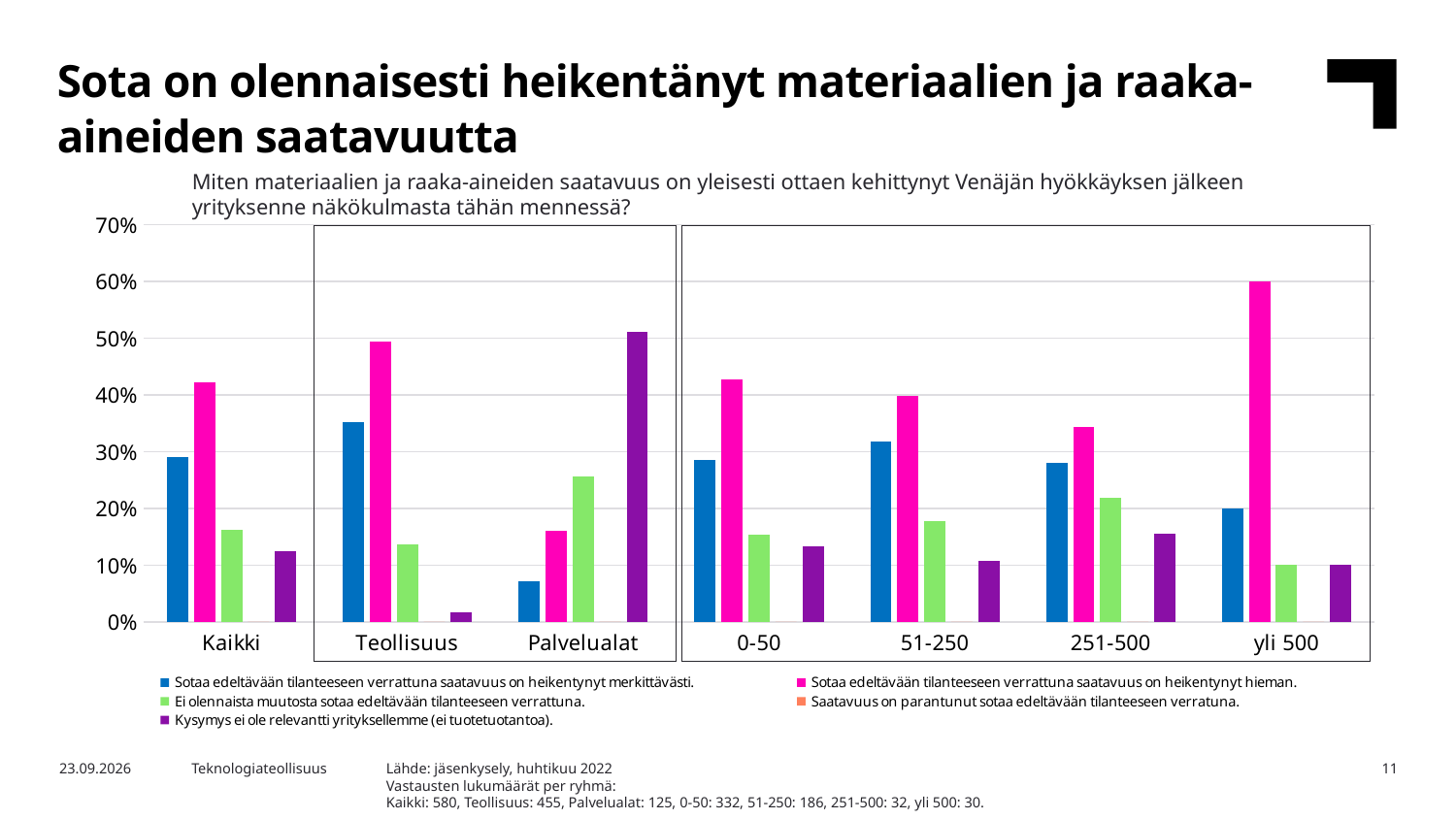
What kind of chart is shown on the slide? bar chart Is the value of 'Kysymys ei ole relevantti yrityksellemme (ei tuotetuotantoa)' for 'Palvelualat' greater or less than 40%? greater What colour represents 'Kysymys ei ole relevantti yrityksellemme (ei tuotetuotantoa)' in the chart? purple How many series does the chart's legend list? 5 Is the value of 'Sotaa edeltävään tilanteeseen verrattuna saatavuus on heikentynyt hieman' for 'yli 500' greater or less than 50%? greater Which category has the lowest value for 'Sotaa edeltävään tilanteeseen verrattuna saatavuus on heikentynyt merkittävästi'? Palvelualat Which category has the highest value for 'Kysymys ei ole relevantti yrityksellemme (ei tuotetuotantoa)'? Palvelualat Is the value of 'Sotaa edeltävään tilanteeseen verrattuna saatavuus on heikentynyt merkittävästi' for 'Palvelualat' greater or less than 10%? less For 'Kaikki', which is larger: 'saatavuus on heikentynyt merkittävästi' or 'saatavuus on heikentynyt hieman'? saatavuus on heikentynyt hieman Which category has the highest value for 'Sotaa edeltävään tilanteeseen verrattuna saatavuus on heikentynyt hieman'? yli 500 How many categories are shown along the x axis of the chart? 7